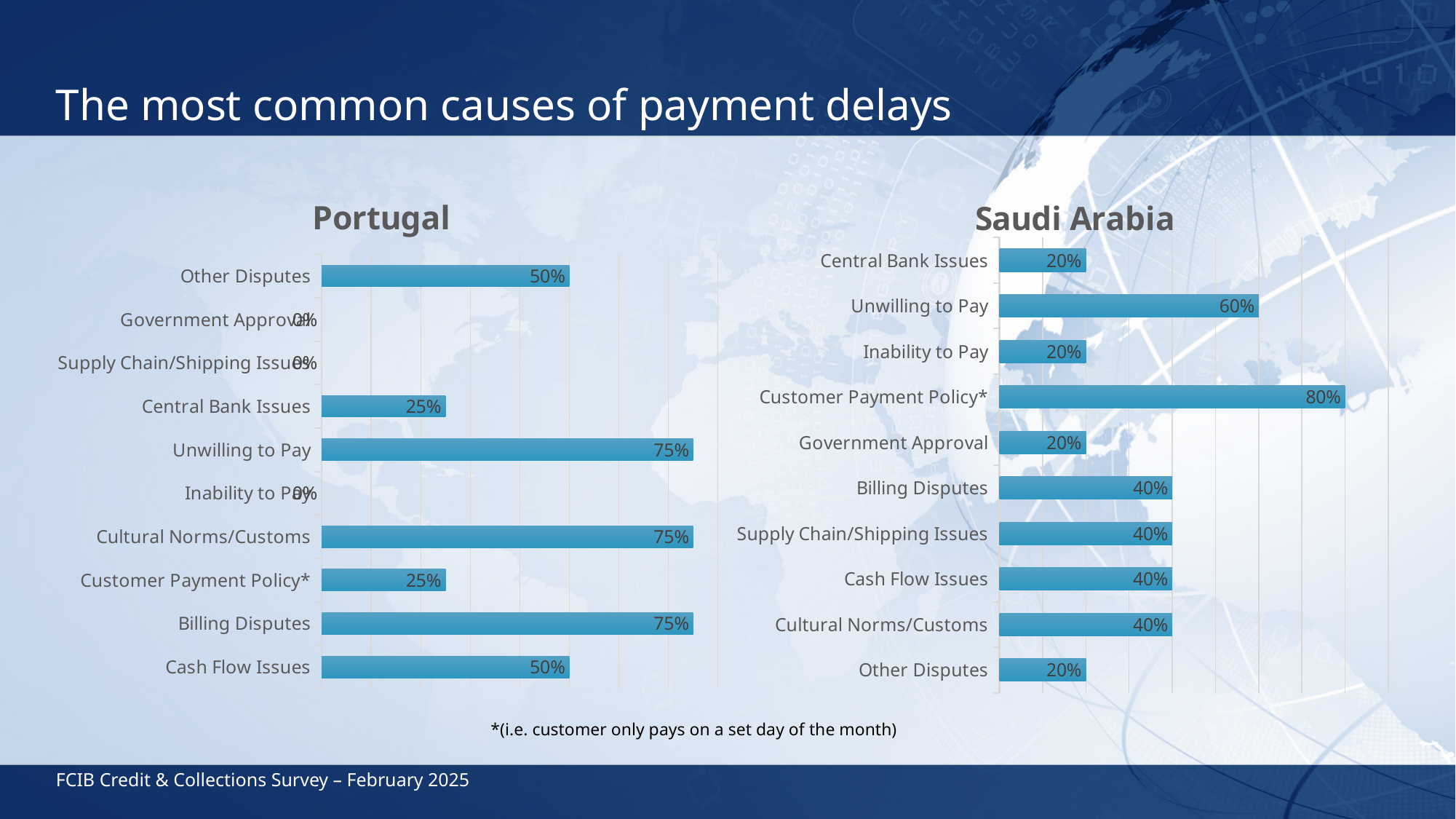
In the Portugal chart, what is the difference between Unwilling to Pay and Cash Flow Issues? 25% In the Portugal chart, what is the value for Other Disputes? 50% In the Saudi Arabia chart, what is the value for Customer Payment Policy*? 80% In the Saudi Arabia chart, which category has the highest value? Customer Payment Policy* What kind of chart is the Portugal chart? Bar chart In the Saudi Arabia chart, which is larger, Unwilling to Pay or Cash Flow Issues? Unwilling to Pay In the Portugal chart, which is larger, Billing Disputes or Customer Payment Policy*? Billing Disputes What is the title of the chart on the right side of the slide? Saudi Arabia How many categories does the Saudi Arabia chart show? 10 In the Saudi Arabia chart, what is the value for Unwilling to Pay? 60% In the Portugal chart, what is the value for Central Bank Issues? 25% In the Saudi Arabia chart, what is the difference between Customer Payment Policy* and Billing Disputes? 40%